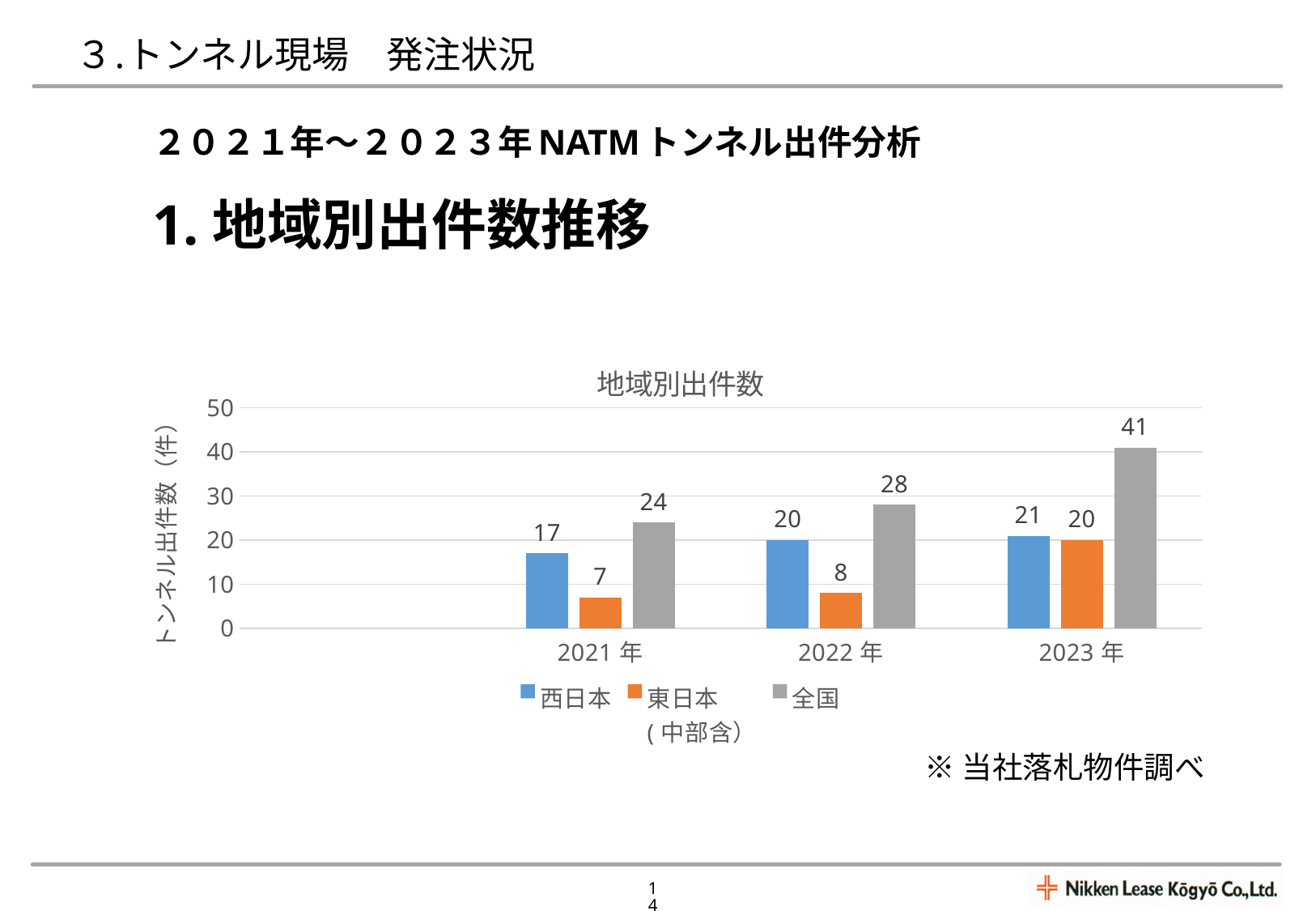
Which year has the highest value for 全国? 2023年 What is the value for 全国 in 2023年? 41 What is the value for 西日本 in 2022年? 20 Do the 全国 values rise or fall from 2021年 to 2023年? rise What is the title of the chart? 地域別出件数 How many series does the legend list? 3 What is the value for 東日本（中部含） in 2021年? 7 What is the difference between the 全国 values for 2023年 and 2022年? 13 Which year has the lowest value for 東日本（中部含）? 2021年 How many years are shown on the x axis? 3 Which is larger in 2023年, 西日本 or 東日本（中部含）? 西日本 What kind of chart is shown? bar chart